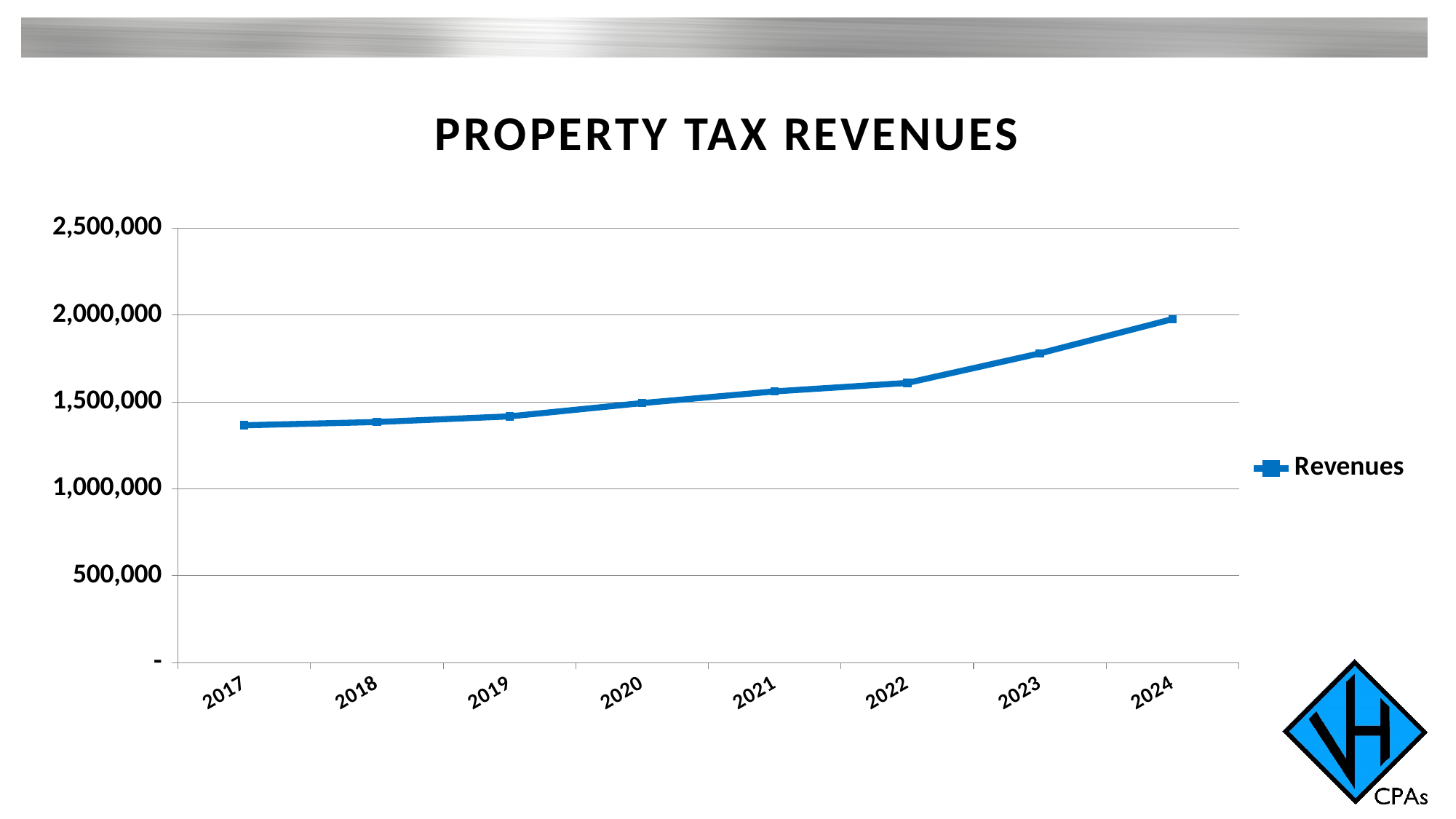
Which year has the larger revenue, 2019 or 2023? 2023 Do property tax revenues rise or fall from 2017 to 2024? rise Which year has the highest property tax revenue? 2024 What kind of chart is shown on the slide? line chart Is the value for 2023 greater or less than 1,500,000? greater Is the value for 2017 greater or less than 1,500,000? less How many years are plotted on the x axis? 8 How many series does the legend list? 1 What is the title of the chart? PROPERTY TAX REVENUES Is the value for 2021 greater or less than 2,000,000? less What is the name of the series shown in the legend? Revenues Which year has the lowest property tax revenue? 2017